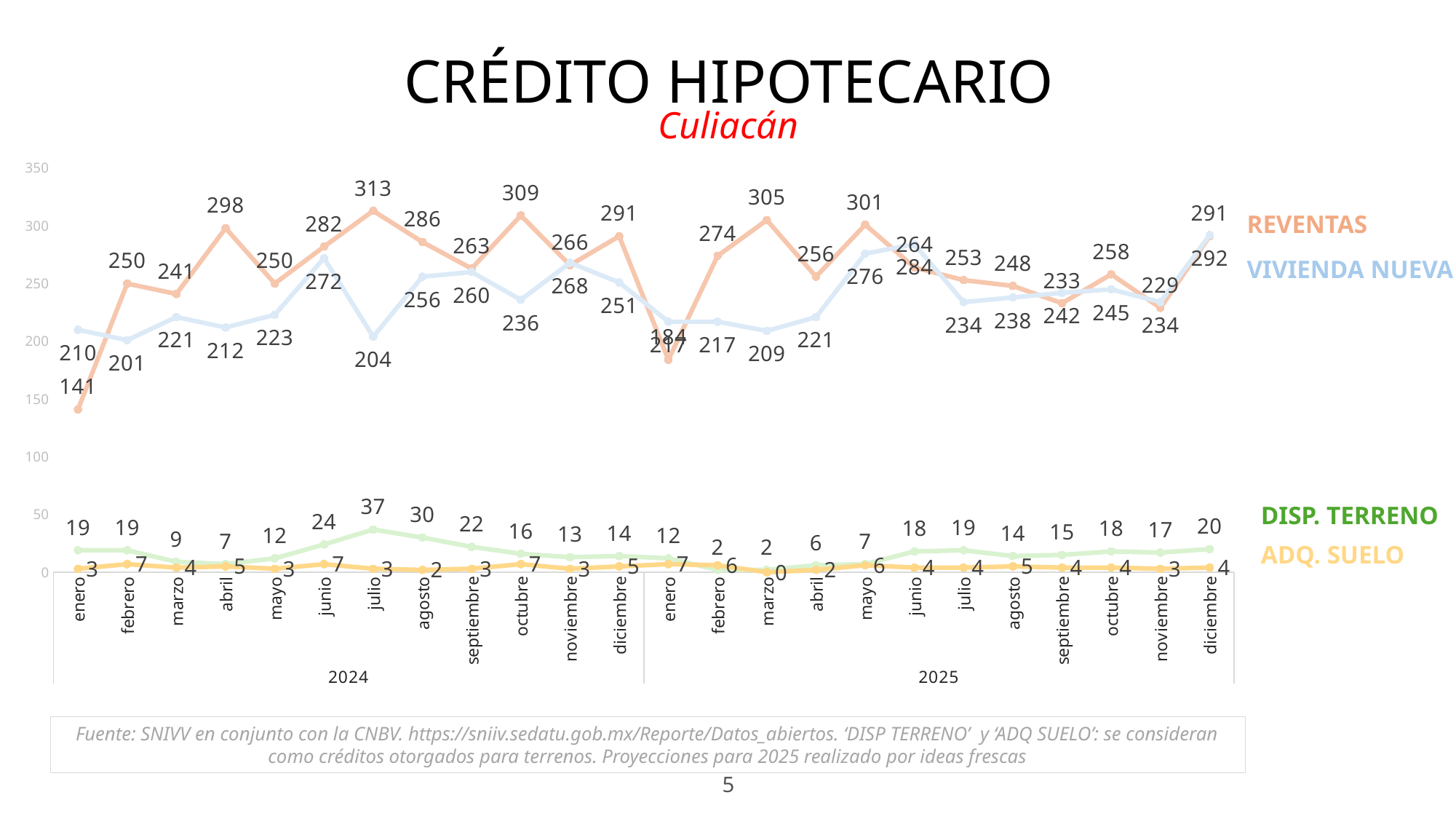
How many monthly data points does each series have? 24 What is the VIVIENDA NUEVA value for diciembre 2025? 292 How many series does the legend list? 4 What is the ADQ. SUELO value for marzo 2025? 0 What is the difference between the REVENTAS values for julio 2024 and enero 2024? 172 What colour is the REVENTAS line? orange In which month is the REVENTAS value highest? julio 2024 What is the highest DISP. TERRENO value shown? 37 In which month is the REVENTAS value lowest? enero 2024 What is the DISP. TERRENO value for julio 2024? 37 In junio 2025, which is larger: REVENTAS or VIVIENDA NUEVA? VIVIENDA NUEVA What kind of chart is shown on the slide? line chart